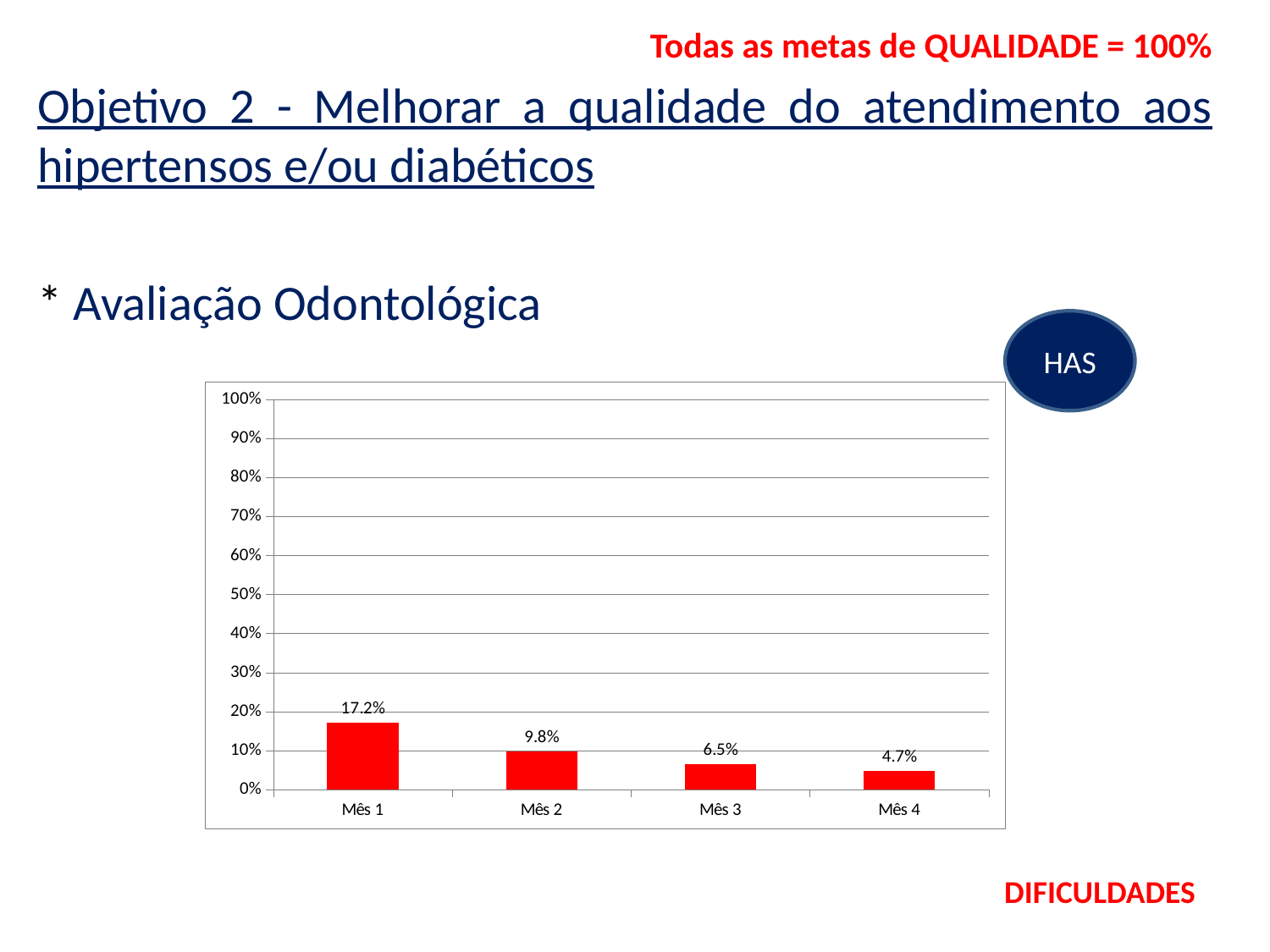
Which month has the lowest value? Mês 4 What kind of chart is shown on the slide? bar chart What is the value for Mês 4? 4.7% Is the value for Mês 1 greater or less than 20%? less Which month has the highest value? Mês 1 Which is larger, the value for Mês 2 or the value for Mês 3? Mês 2 What is the value for Mês 2? 9.8% What is the difference between the values for Mês 1 and Mês 2? 7.4% Do the values rise or fall from Mês 1 to Mês 4? fall What is the value for Mês 3? 6.5% What is the value for Mês 1? 17.2% How many months are shown on the x axis? 4